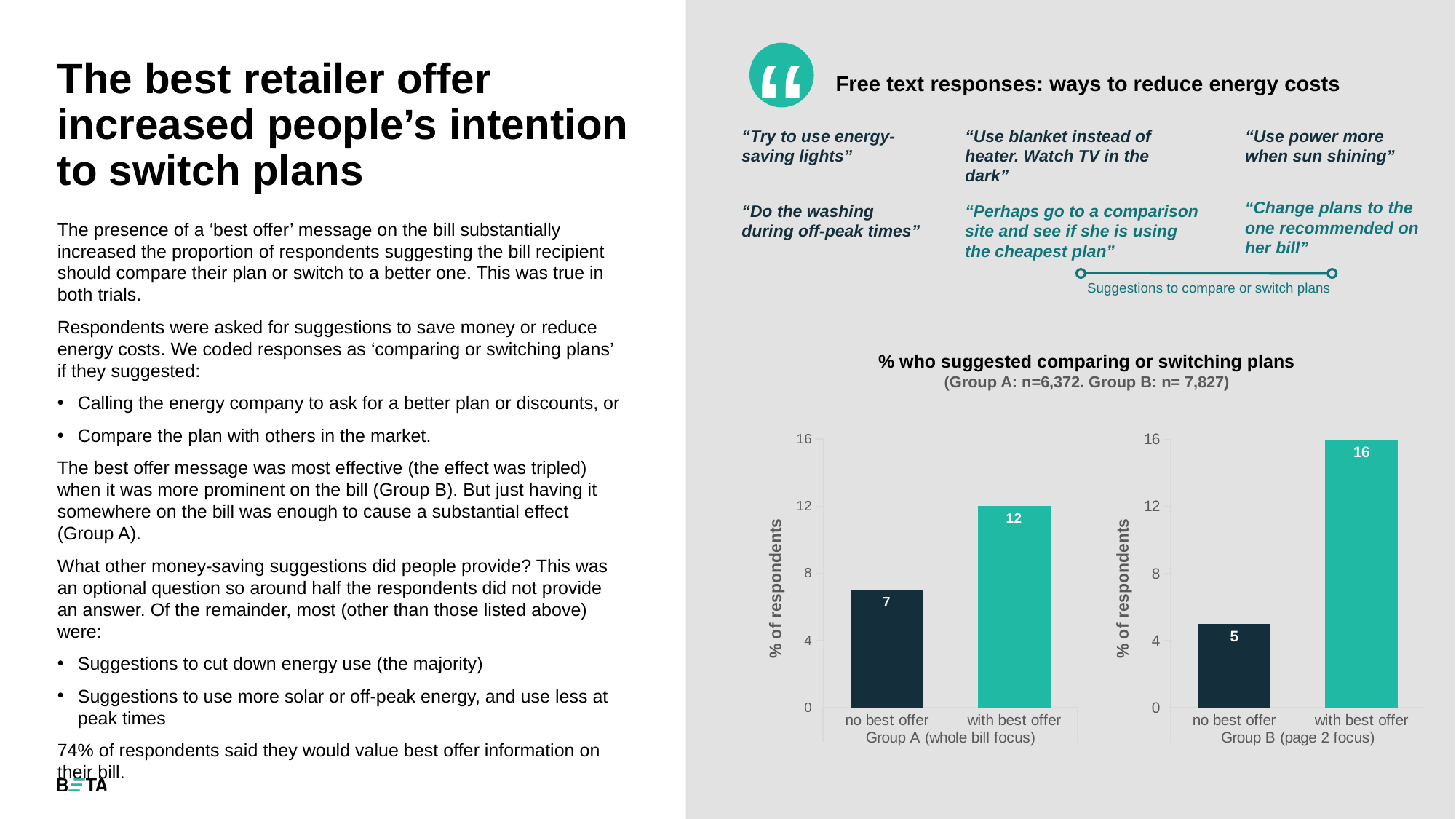
In the Group A (whole bill focus) chart, what is the value for 'with best offer'? 12 In the Group B (page 2 focus) chart, what is the value for 'no best offer'? 5 In the Group B (page 2 focus) chart, which category has the highest value? with best offer In the Group A (whole bill focus) chart, which category has the lowest value? no best offer What kind of chart is used for the Group A (whole bill focus) data? bar chart In the Group A (whole bill focus) chart, what is the difference between 'with best offer' and 'no best offer'? 5 Which is larger: 'with best offer' in Group A or 'with best offer' in Group B? with best offer in Group B In the Group B (page 2 focus) chart, what is the difference between 'with best offer' and 'no best offer'? 11 What is the y-axis label on the Group A (whole bill focus) chart? % of respondents In the Group B (page 2 focus) chart, what is the value for 'with best offer'? 16 How many bars are in the Group B (page 2 focus) chart? 2 In the Group A (whole bill focus) chart, what is the value for 'no best offer'? 7